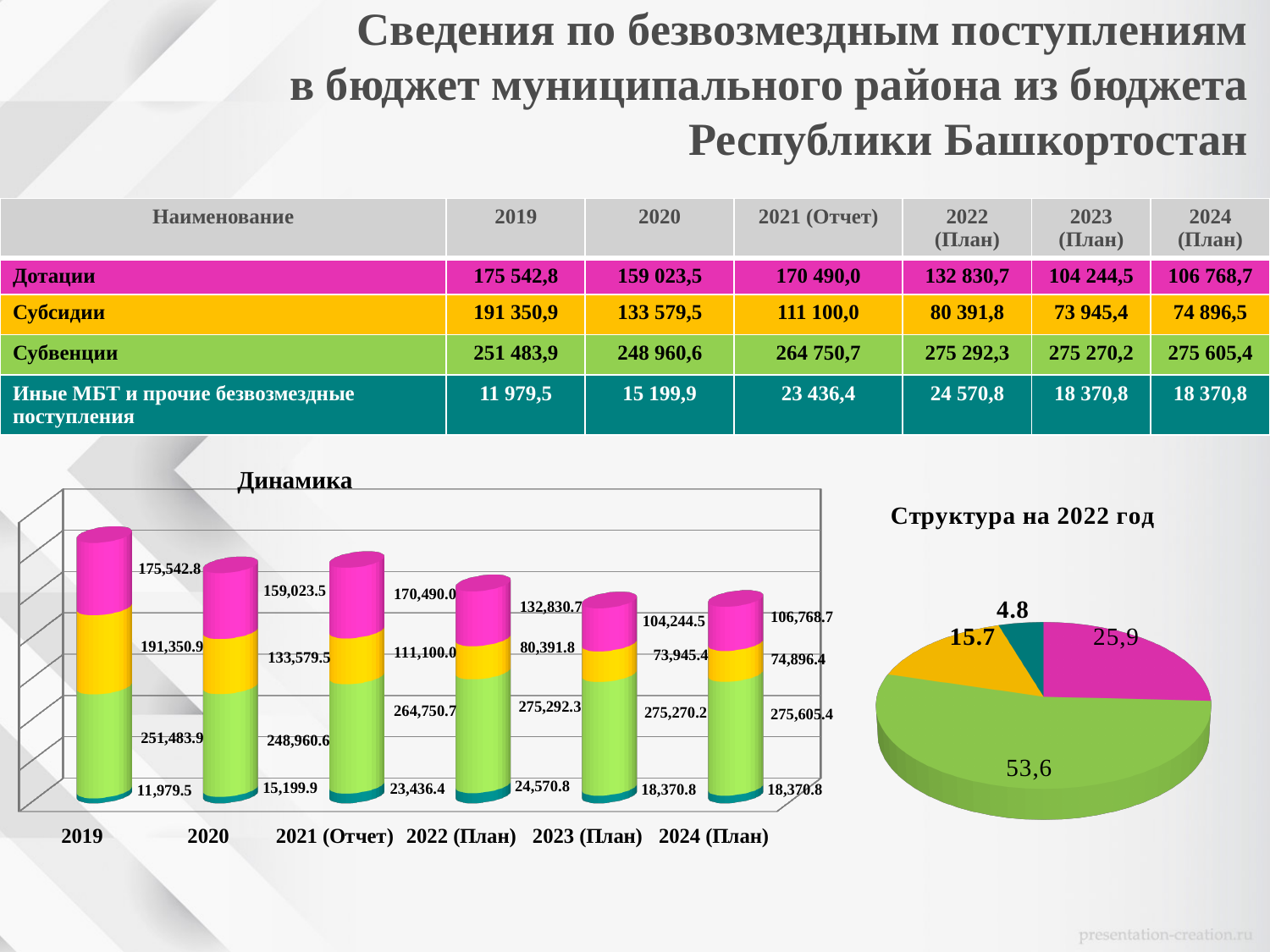
In the "Динамика" chart, is the pink segment larger in 2019 or in 2024 (План)? 2019 In the "Динамика" chart, what is the difference between the green segment for 2024 (План) and the green segment for 2019? 24,121.5 In the "Динамика" chart, which year has the smallest teal (bottom) segment? 2019 In the "Структура на 2022 год" pie chart, what is the share of the largest slice? 53,6 In the "Динамика" chart, what is the value of the pink (top) segment for 2019? 175,542.8 In the "Динамика" chart, which year has the tallest stacked bar? 2019 What kind of chart is the "Динамика" chart on the left of the slide? bar chart How many year categories are shown along the x axis of the "Динамика" chart? 6 In the "Динамика" chart, what is the value of the green segment for 2022 (План)? 275,292.3 What is the title of the pie chart on the right of the slide? Структура на 2022 год In the "Динамика" chart, what is the total of the stacked bar for 2019? 630,357.1 In the "Динамика" chart, what is the value of the teal (bottom) segment for 2021 (Отчет)? 23,436.4